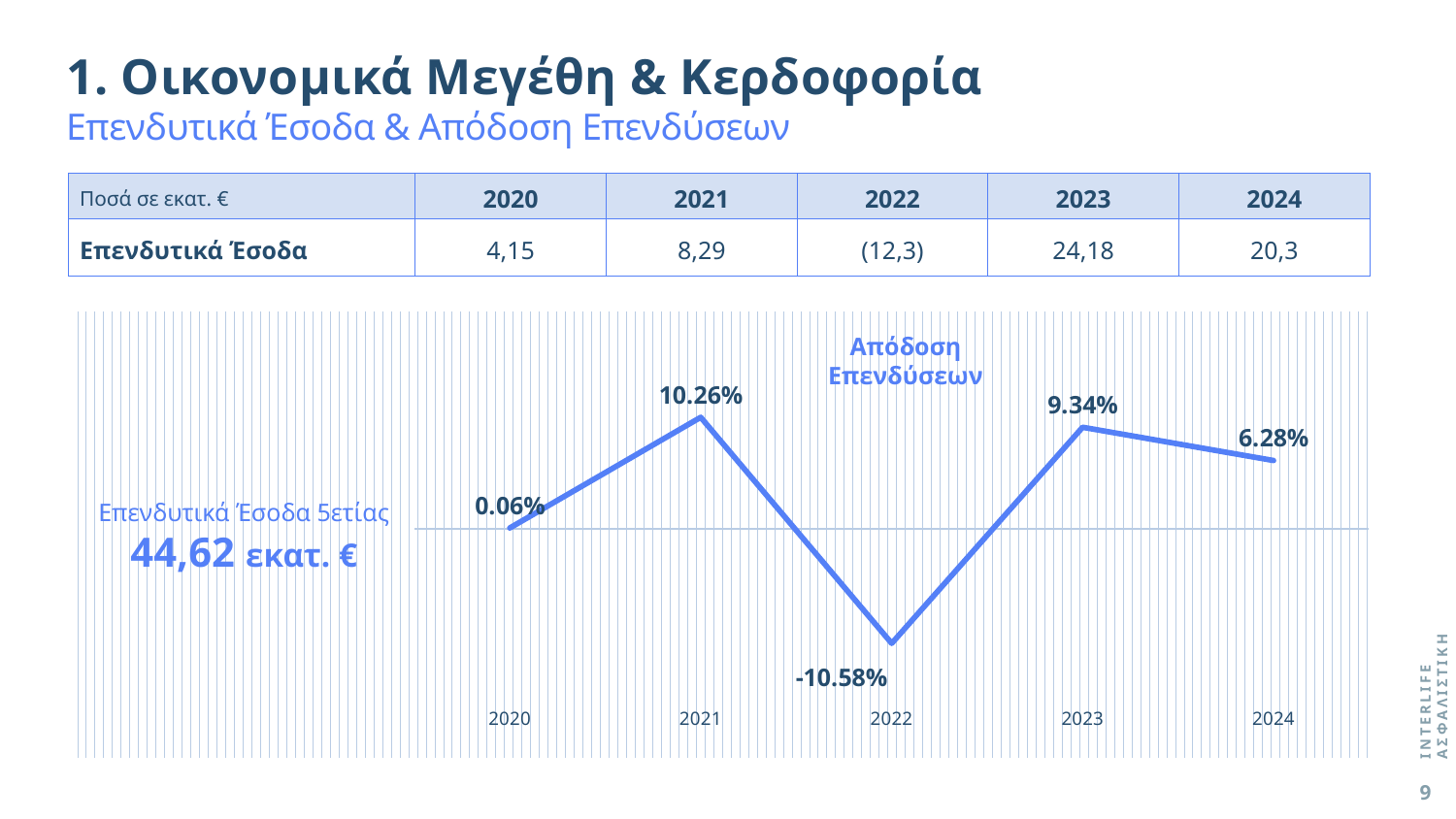
What is the value for 2021 in the chart? 10.26% What is the difference between the values for 2021 and 2023 in the chart? 0.92% What is the title of the chart? Απόδοση Επενδύσεων What is the value for 2020 in the chart? 0.06% Does the value rise or fall from 2023 to 2024 in the chart? fall What is the value for 2024 in the chart? 6.28% Which is larger in the chart, the value for 2023 or the value for 2024? 2023 Which year has the highest value in the chart? 2021 What type of chart is shown on the slide? line chart Which year has the lowest value in the chart? 2022 How many data points are plotted in the chart? 5 What is the value for 2022 in the chart? -10.58%